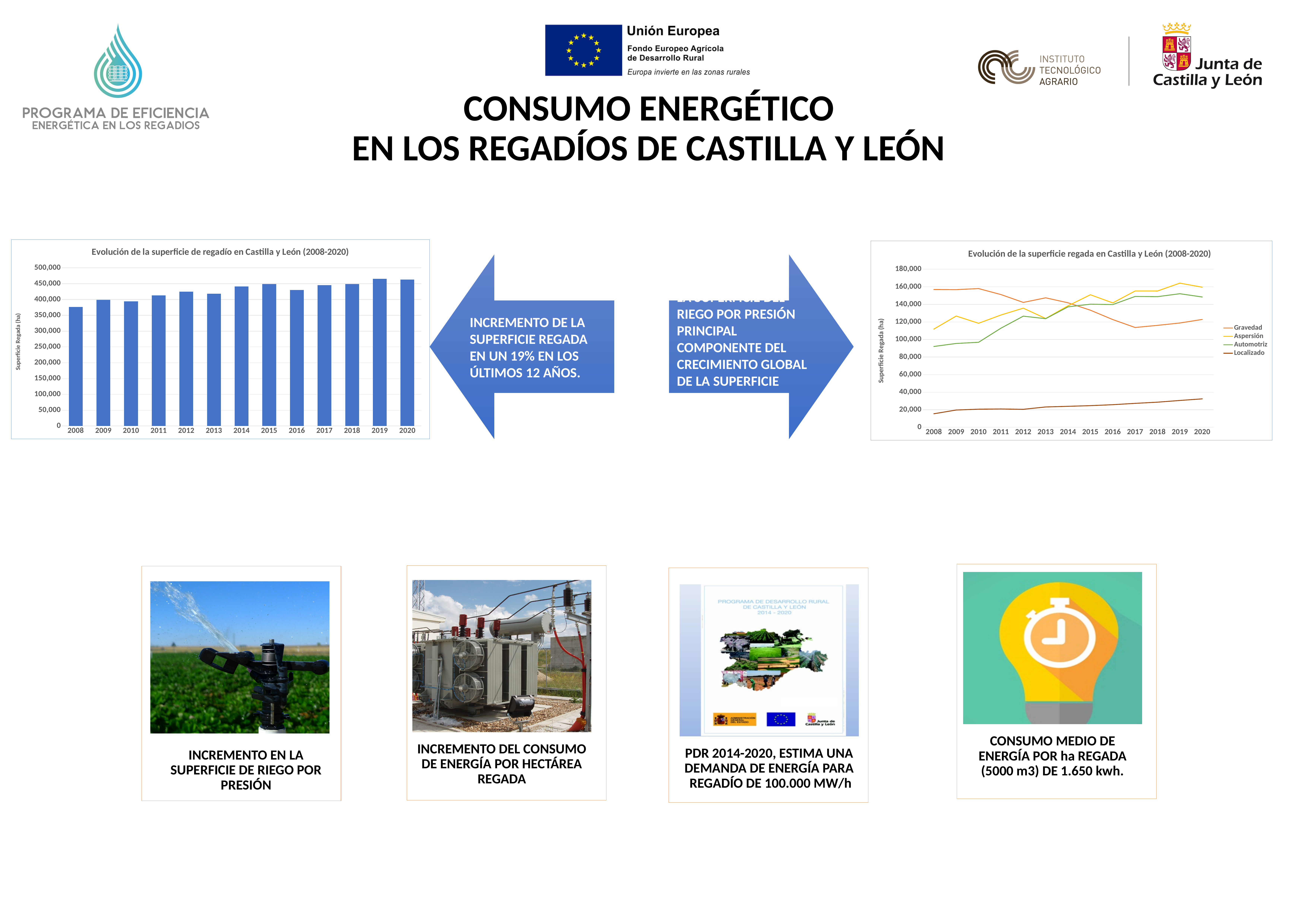
In the left bar chart, which year has the lowest irrigated surface? 2008 In the right line chart, is the value for Localizado in 2020 greater or less than 40,000? less In the left bar chart, is the value for 2008 greater or less than 400,000? less In the right line chart, which series has the lowest values across all years? Localizado In the left bar chart, is the value for 2014 greater or less than 400,000? greater In the left bar chart, is the value for 2012 larger than the value for 2008? yes What type of chart is the left chart titled 'Evolución de la superficie de regadío en Castilla y León (2008-2020)'? bar chart In the right line chart, does the Gravedad series rise or fall from 2008 to 2020? fall In the right line chart, which series is larger in 2020, Aspersión or Gravedad? Aspersión What type of chart is the right chart titled 'Evolución de la superficie regada en Castilla y León (2008-2020)'? line chart How many years are shown on the x axis of the left bar chart? 13 How many series does the legend of the right line chart list? 4